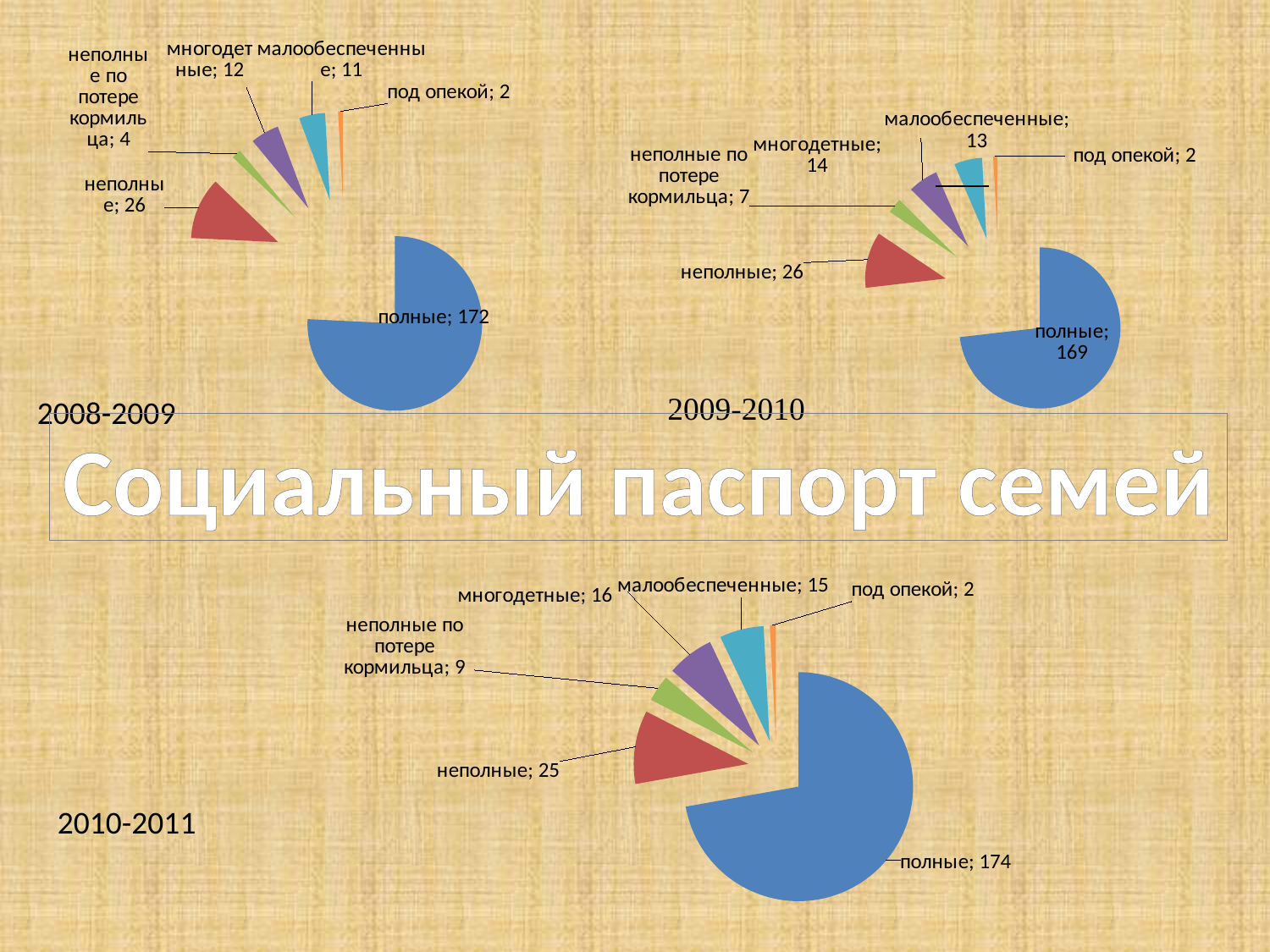
In the 2009-2010 chart, which category has the smallest slice? под опекой In the 2008-2009 chart, what is the value for полные? 172 In the 2009-2010 chart, what is the value for многодетные? 14 In the 2008-2009 chart, what is the difference between неполные and многодетные? 14 In the 2009-2010 chart, what is the difference between полные and неполные? 143 What is the title of the slide? Социальный паспорт семей How many categories does the 2009-2010 chart show? 6 In the 2010-2011 chart, which category has the largest slice? полные How many pie charts are on the slide? 3 What kind of chart is used for 2010-2011? pie chart In the 2010-2011 chart, which is larger: многодетные or малообеспеченные? многодетные In the 2010-2011 chart, what is the value for неполные по потере кормильца? 9